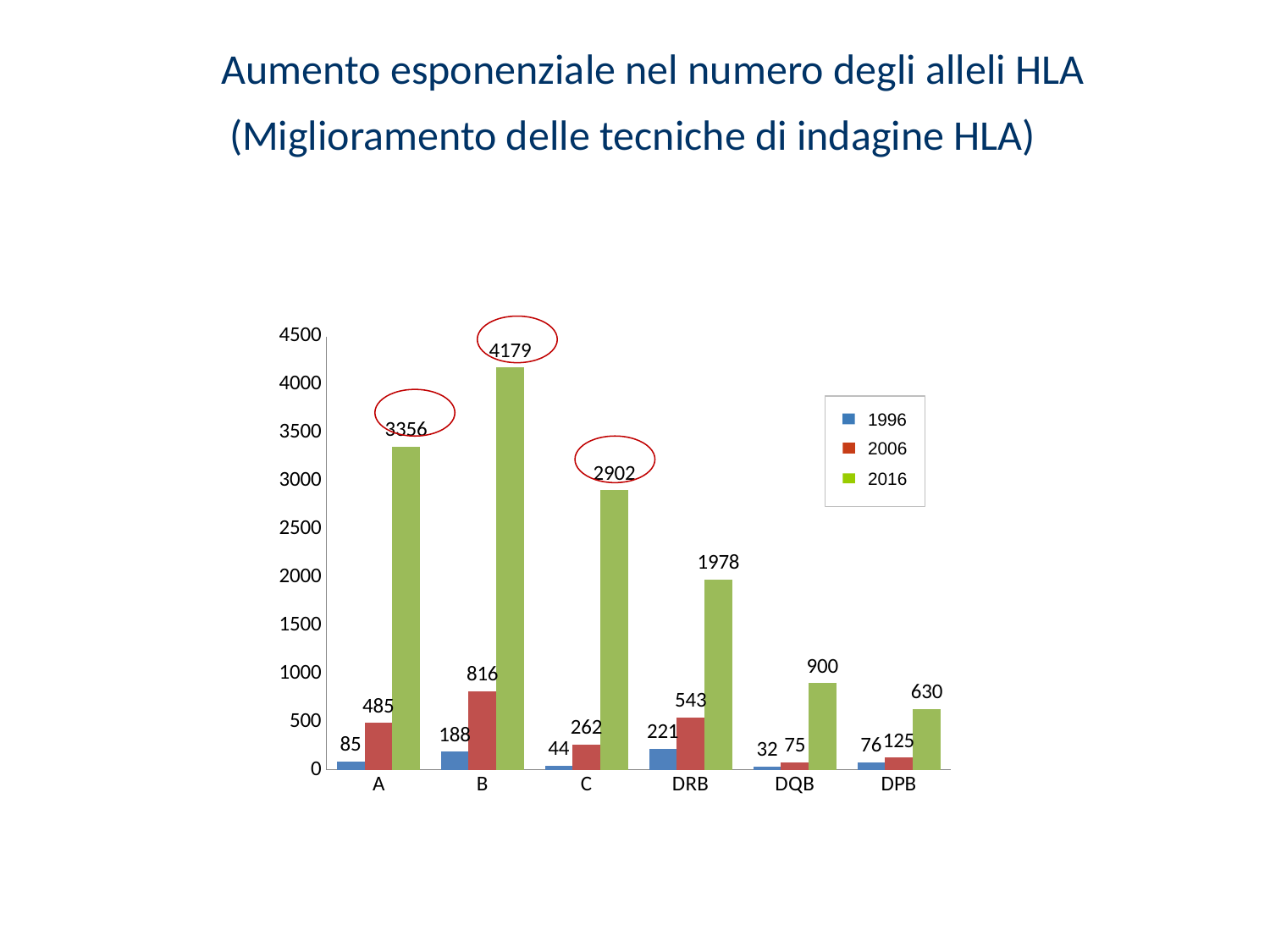
Which category has the lowest value in the 1996 series? DQB Which is larger: the 2016 value for DRB or the 2016 value for DQB? DRB How many series does the legend list? 3 How many categories are shown on the x axis? 6 Is the 2016 value for C greater or less than 3000? less What is the difference between the 2016 and 2006 values for A? 2871 What is the value for C in the 1996 series? 44 What kind of chart is shown on the slide? bar chart What is the value for DRB in the 2006 series? 543 What is the value for B in the 2016 series? 4179 Which category has the highest value in the 2016 series? B Which series is shown in green in the legend? 2016